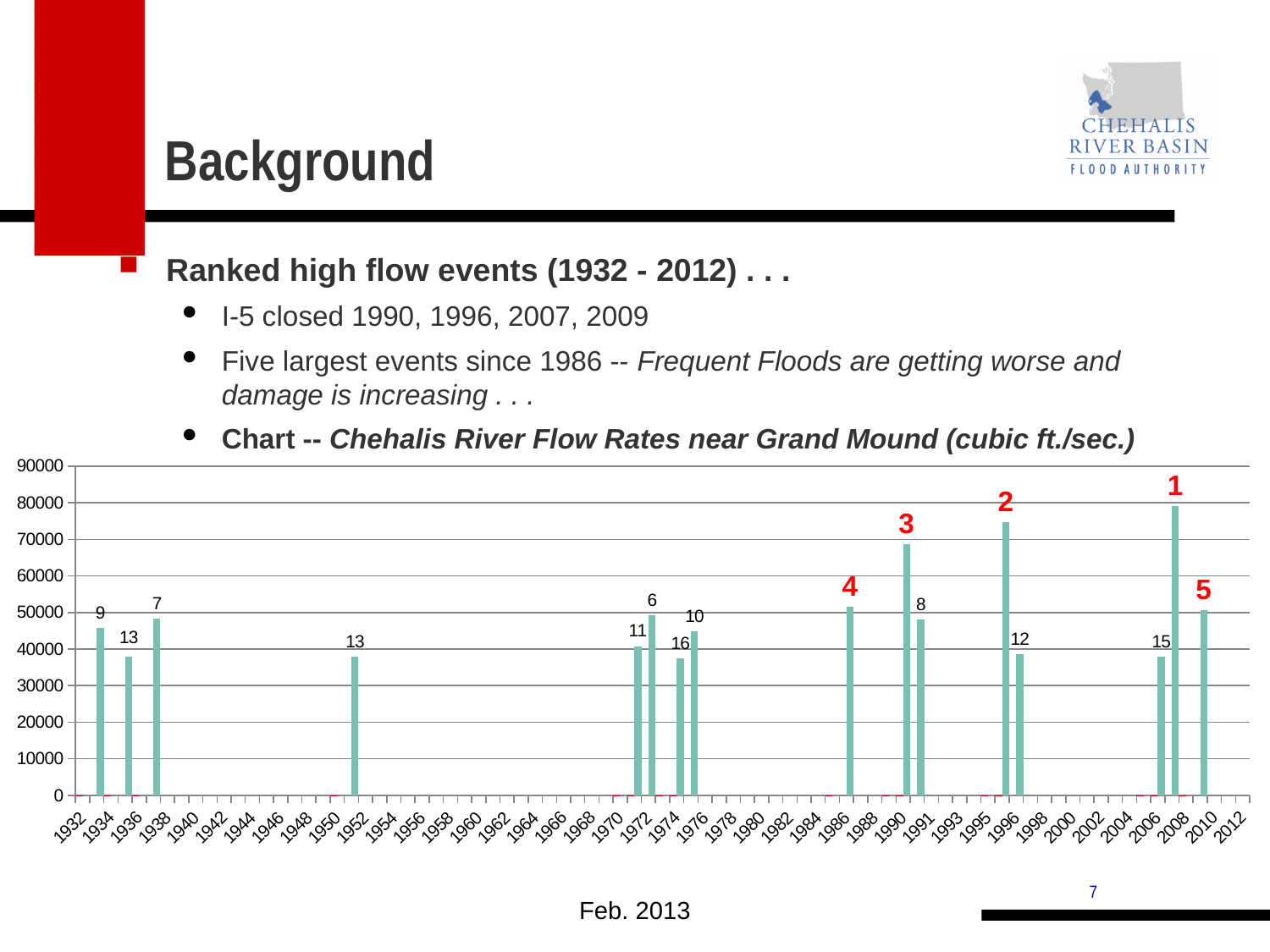
Is the value of the bar labeled 16 greater or less than 40000? less What kind of chart is shown on the slide? bar chart Is the value of the bar labeled 5 greater or less than 40000? greater How many bars carry a rank label in the chart? 16 Which bar is the highest in the chart? the bar labeled 1 Is the value of the bar labeled 1 greater or less than 70000? greater Which is larger, the bar labeled 2 or the bar labeled 3? the bar labeled 2 Which is larger, the bar labeled 1 or the bar labeled 5? the bar labeled 1 What is the title of the chart on the slide? Chehalis River Flow Rates near Grand Mound (cubic ft./sec.) What is the highest value shown on the chart's vertical axis? 90000